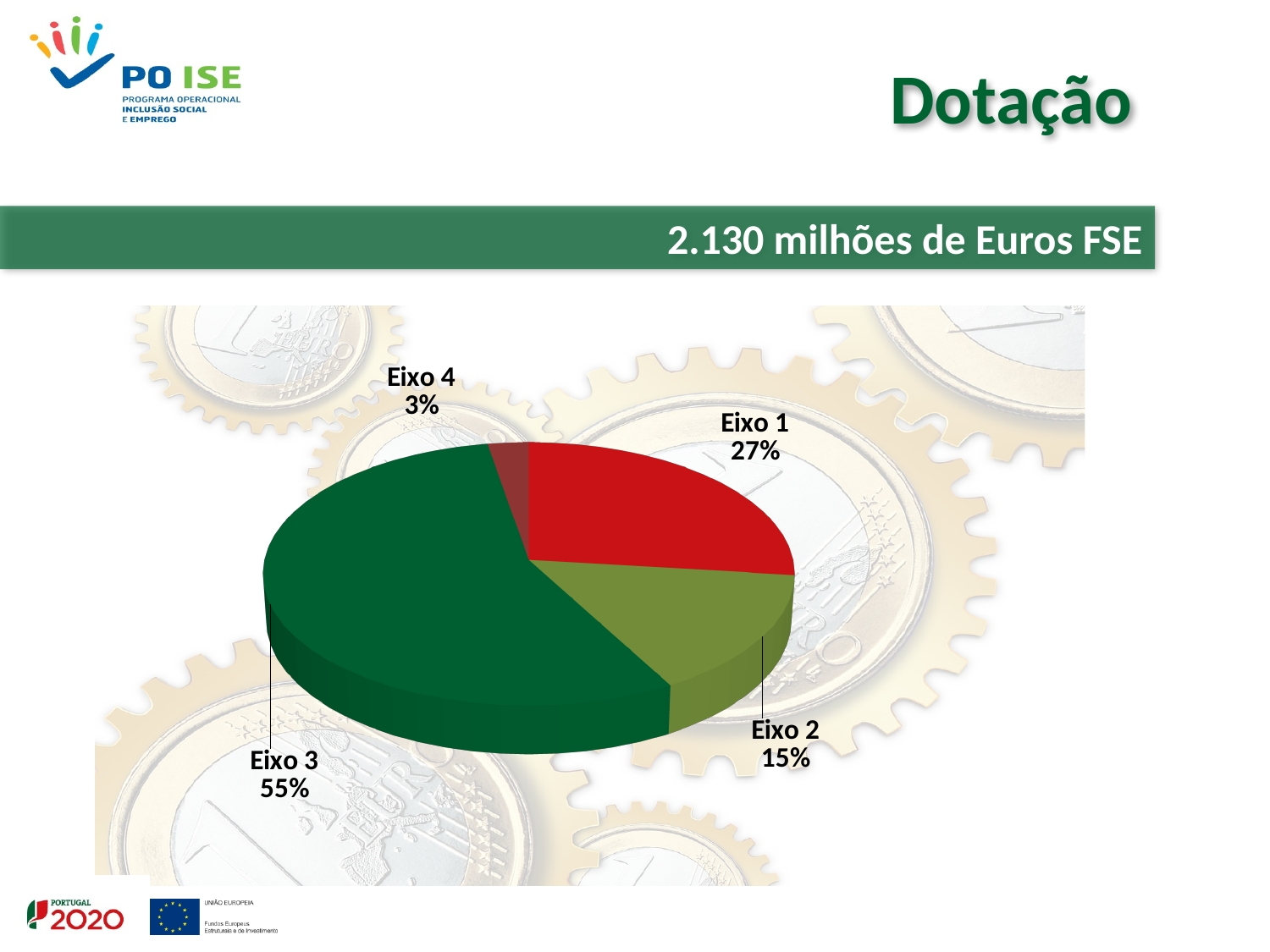
What is the value shown for Eixo 2? 15% Which slice of the pie is the smallest? Eixo 4 Which is larger, Eixo 2 or Eixo 4? Eixo 2 How many slices does the pie chart have? 4 Which slice of the pie is the largest? Eixo 3 What is the difference in percentage points between Eixo 3 and Eixo 1? 28 What is the value shown for Eixo 4? 3% What is the difference in percentage points between Eixo 1 and Eixo 2? 12 What share of the pie does Eixo 1 represent? 27% What kind of chart is shown on the slide? pie chart What share of the pie does Eixo 3 represent? 55% What total amount is stated in the green banner above the chart? 2.130 milhões de Euros FSE